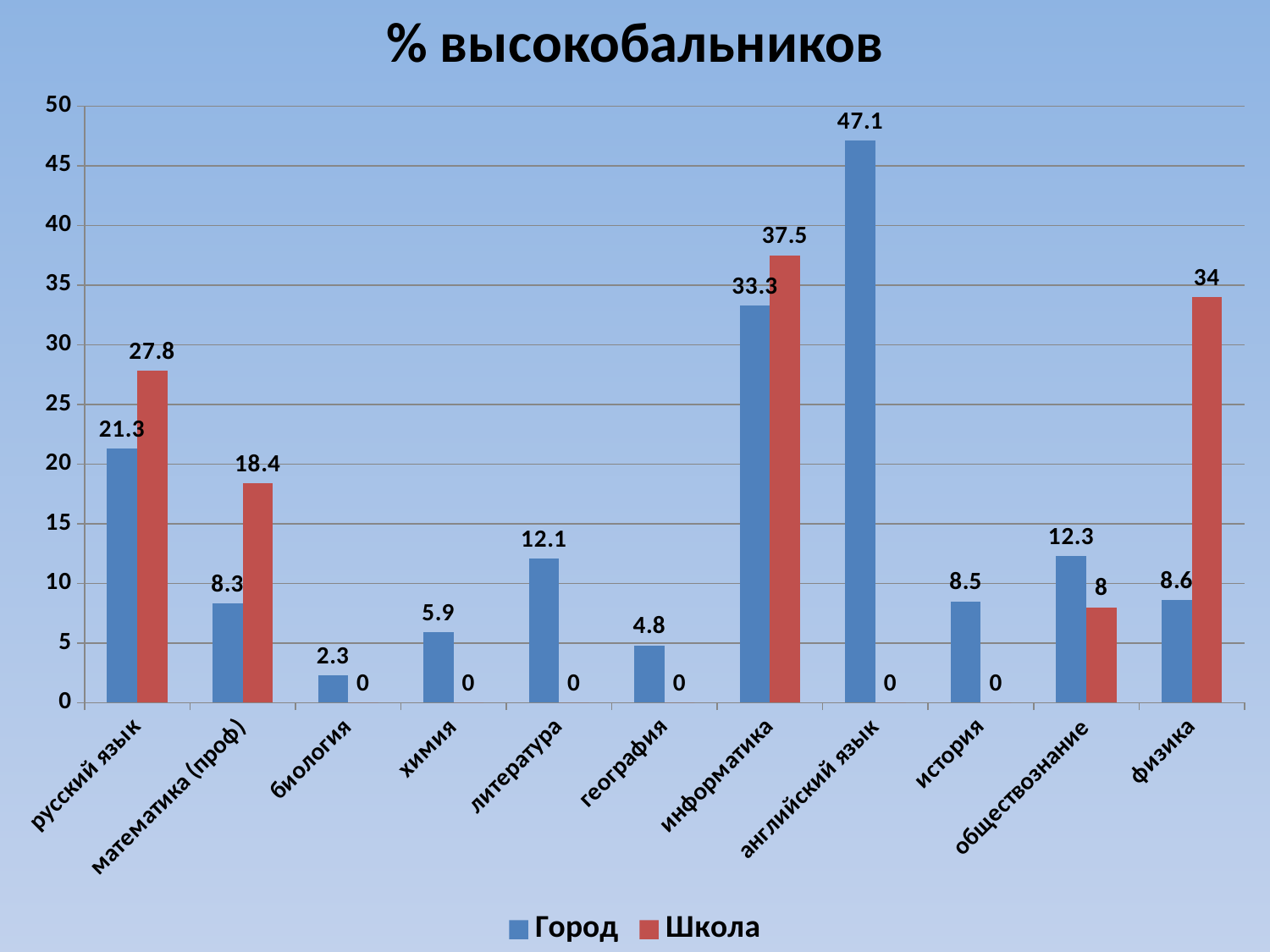
Which is larger for обществознание, the Город value or the Школа value? Город Which category has the lowest value for Город? биология What is the value for Школа for физика? 34 What is the title of the chart? % высокобальников What kind of chart is shown on the slide? bar chart What is the difference between the Школа and Город values for русский язык? 6.5 What is the value for Школа for математика (проф)? 18.4 Which category has the highest value for Школа? информатика How many series does the legend list? 2 Which category has the highest value for Город? английский язык What is the value for Город for английский язык? 47.1 How many categories are shown on the x axis? 11